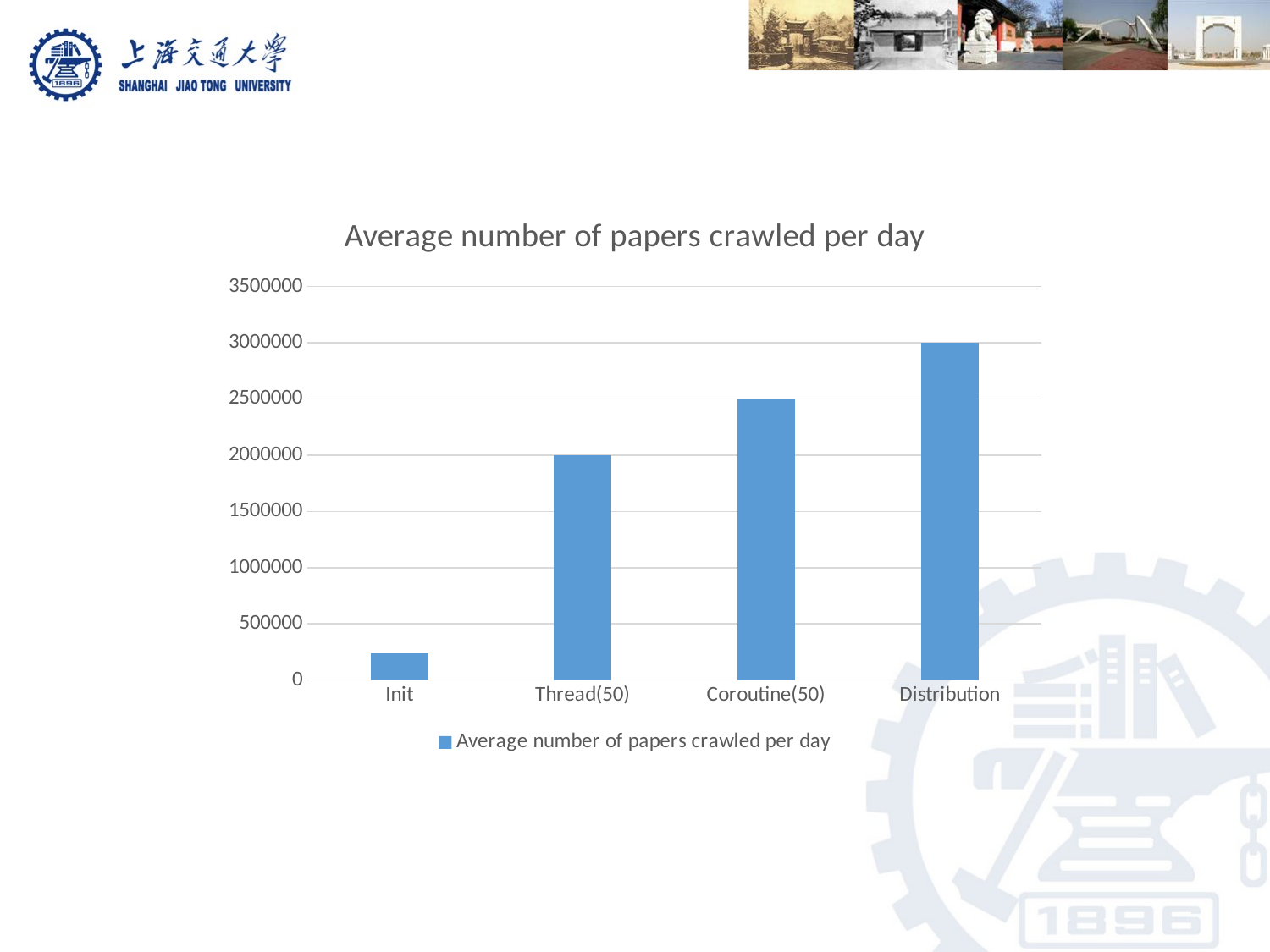
What is the value for Coroutine(50)? 2500000 How many categories are shown on the x axis of the chart? 4 Is the value for Init greater or less than 500000? less Which category has the lowest average number of papers crawled per day? Init What type of chart is shown on the slide? bar chart What is the title of the chart? Average number of papers crawled per day Do the values rise or fall from Init to Distribution along the x axis? rise How many series does the legend list? 1 What is the difference between the values for Distribution and Thread(50)? 1000000 What is the value for Distribution? 3000000 Which category has the highest average number of papers crawled per day? Distribution What is the value for Thread(50)? 2000000